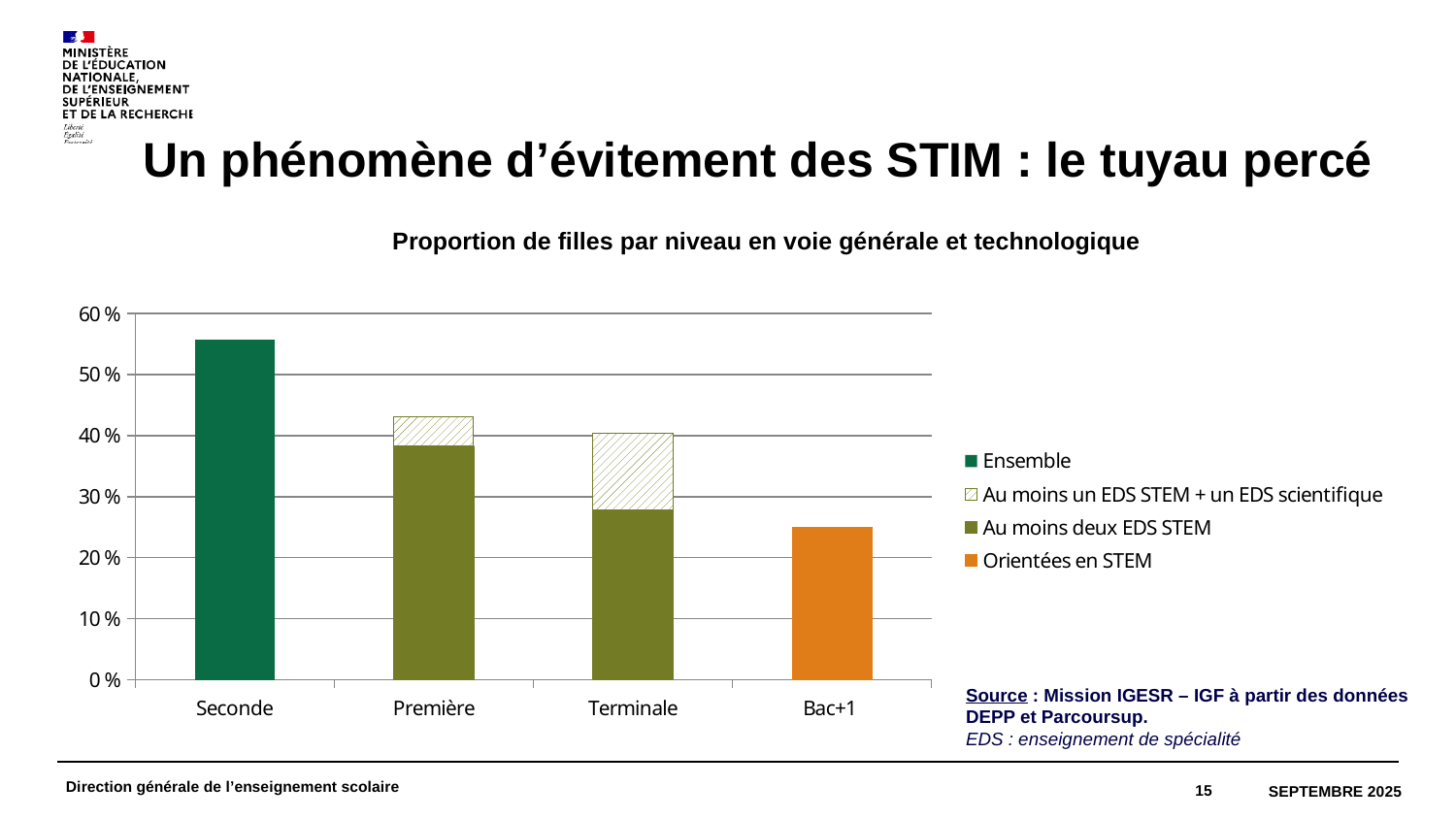
How many categories are shown on the x axis of the chart? 4 What is the title of the chart? Proportion de filles par niveau en voie générale et technologique Which is larger: the bar for Seconde or the bar for Bac+1? Seconde What kind of chart is shown on the slide? bar chart Which category has the lowest total bar height in the chart? Bac+1 Do the bar heights rise or fall from Seconde to Bac+1 along the x axis? fall Is the total bar height for Première greater or less than 50 %? less How many series does the chart's legend list? 4 Is the value for Bac+1 greater or less than 20 %? greater Is the value for Seconde greater or less than 50 %? greater Which category has the highest bar in the chart? Seconde